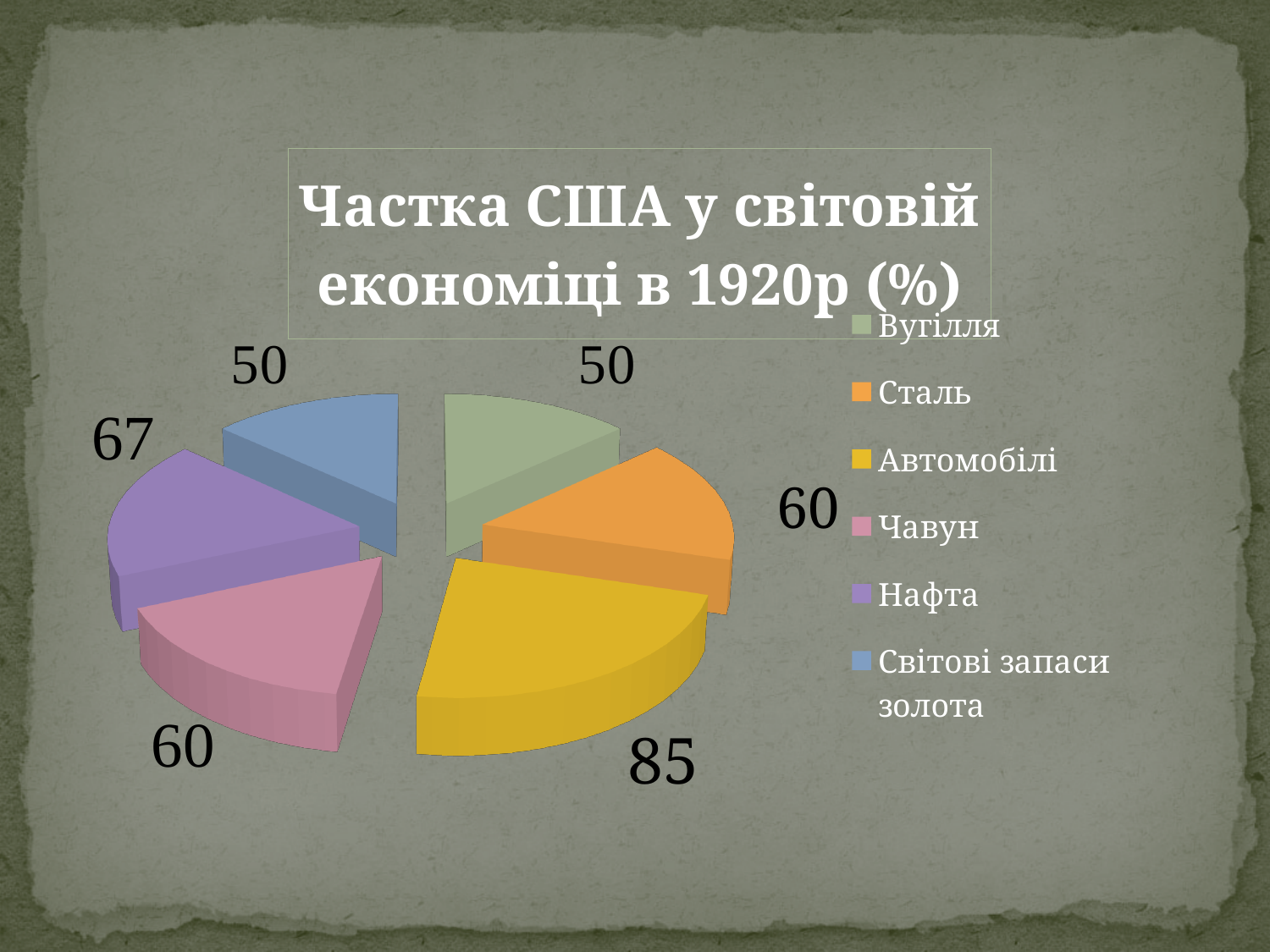
What is the value for Сталь? 60 Which category has the largest slice? Автомобілі What is the value for Вугілля? 50 What is the title of the chart? Частка США у світовій економіці в 1920р (%) What is the value for Нафта? 67 What colour is the slice for Автомобілі? yellow What is the value for Автомобілі? 85 What is the difference between the values for Нафта and Чавун? 7 Which is larger, the value for Нафта or the value for Сталь? Нафта How many categories does the pie chart have? 6 What type of chart is shown on the slide? pie chart What is the difference between the values for Автомобілі and Світові запаси золота? 35